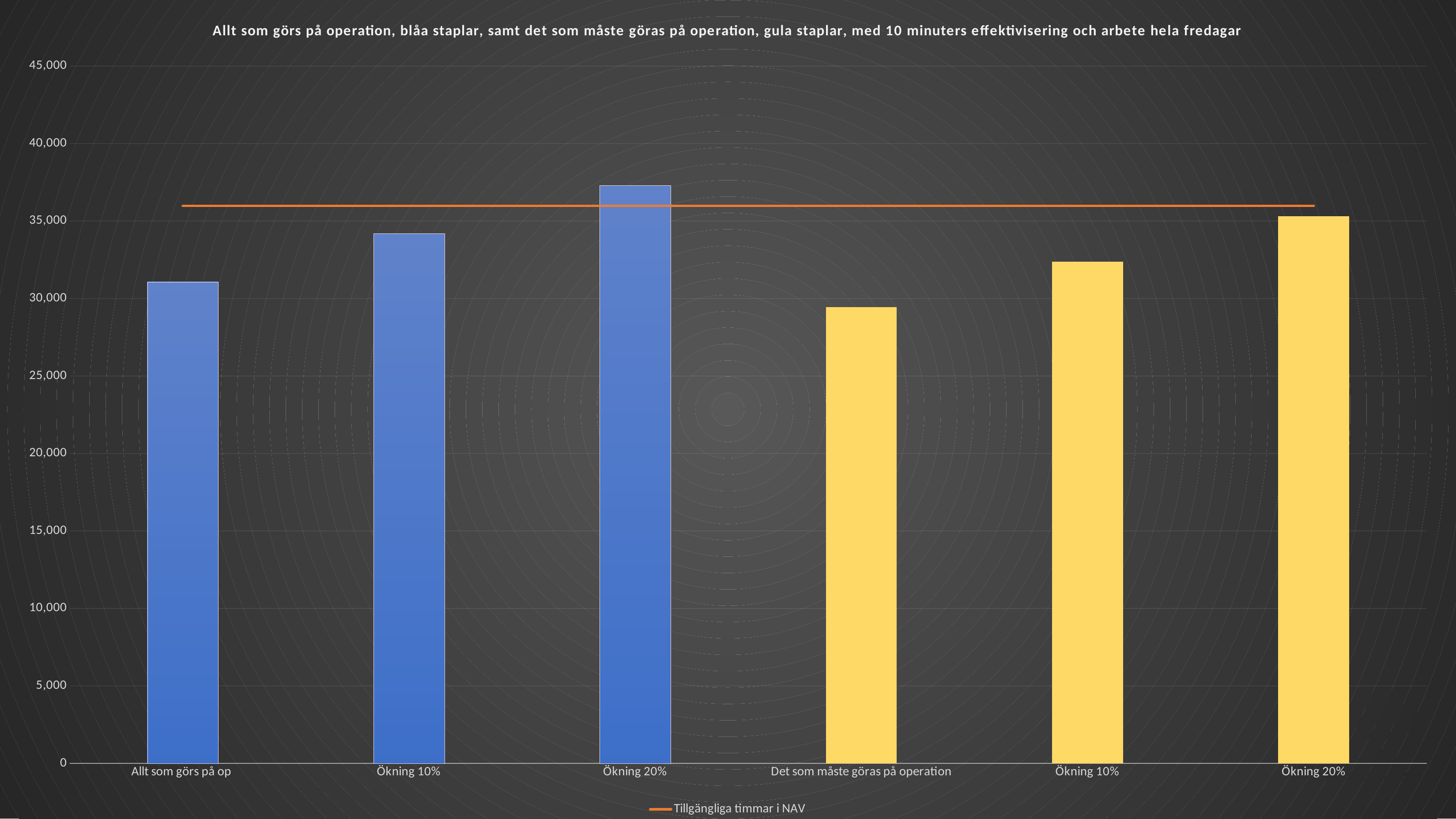
What kind of chart is shown on the slide? bar chart Is the value of the blue bar 'Ökning 20%' greater or less than 35,000? greater Which is larger: the blue 'Ökning 10%' bar or the yellow 'Ökning 10%' bar? the blue 'Ökning 10%' bar Which bar is the tallest in the chart? Ökning 20% (blue) Is the value of the blue bar 'Allt som görs på op' greater or less than 30,000? greater Is the value of the yellow bar 'Det som måste göras på operation' greater or less than 30,000? less What is the name of the series shown in the legend? Tillgängliga timmar i NAV Do the three blue bars rise or fall from left to right? rise What colour is the horizontal line representing Tillgängliga timmar i NAV? orange How many entries does the legend list? 1 How many bars are plotted in the chart? 6 Which bar is the shortest in the chart? Det som måste göras på operation